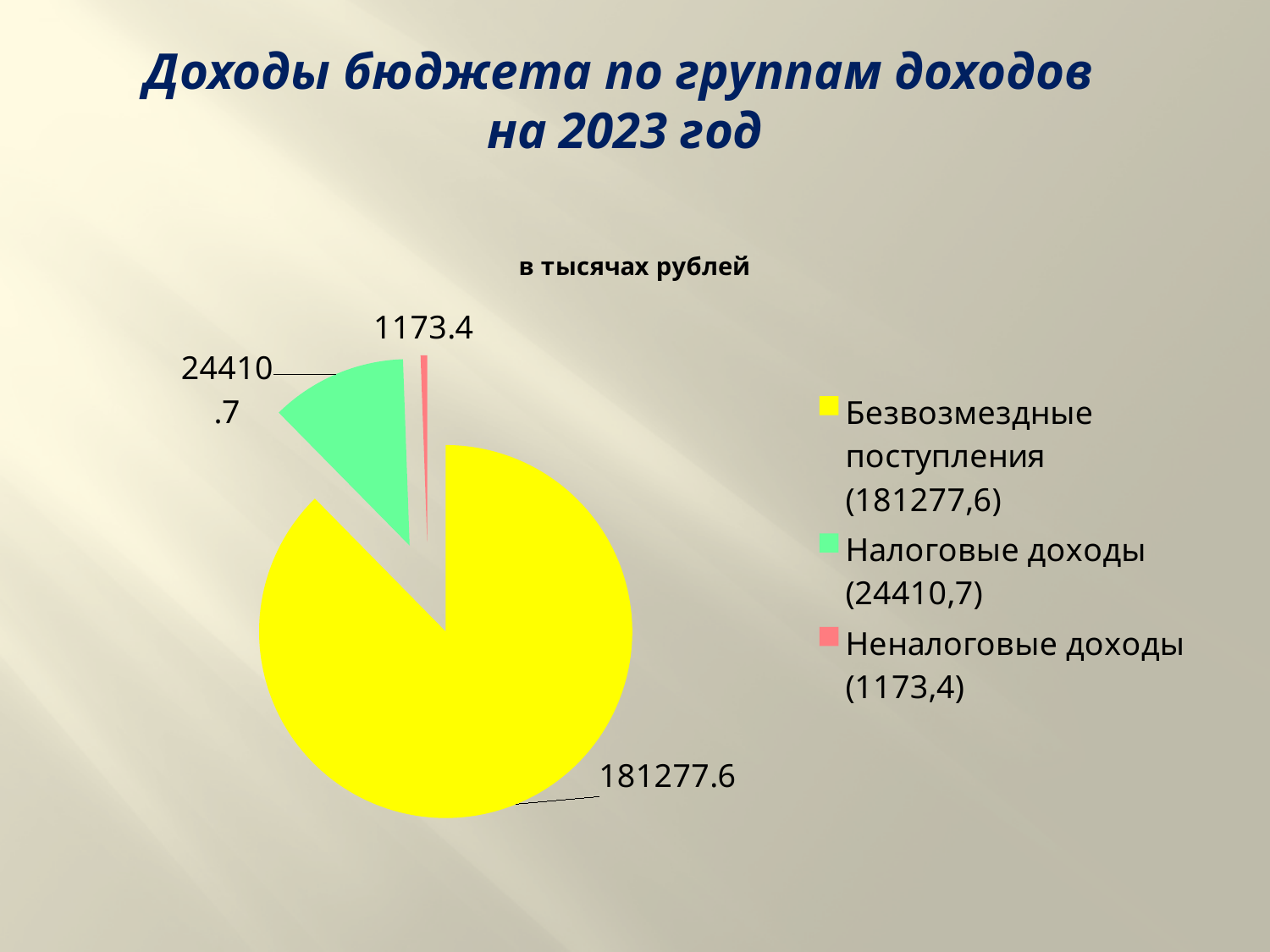
What colour is the slice for Налоговые доходы? green What is the value for Безвозмездные поступления? 181277.6 Which category has the largest slice of the pie? Безвозмездные поступления Which is larger, Налоговые доходы or Неналоговые доходы? Налоговые доходы What is the title shown above the pie chart? в тысячах рублей What type of chart is shown on the slide? pie chart What is the value for Налоговые доходы? 24410.7 What is the value for Неналоговые доходы? 1173.4 How many slices does the pie chart have? 3 What is the difference between Безвозмездные поступления and Налоговые доходы? 156866.9 What is the difference between Налоговые доходы and Неналоговые доходы? 23237.3 Which category has the smallest slice of the pie? Неналоговые доходы